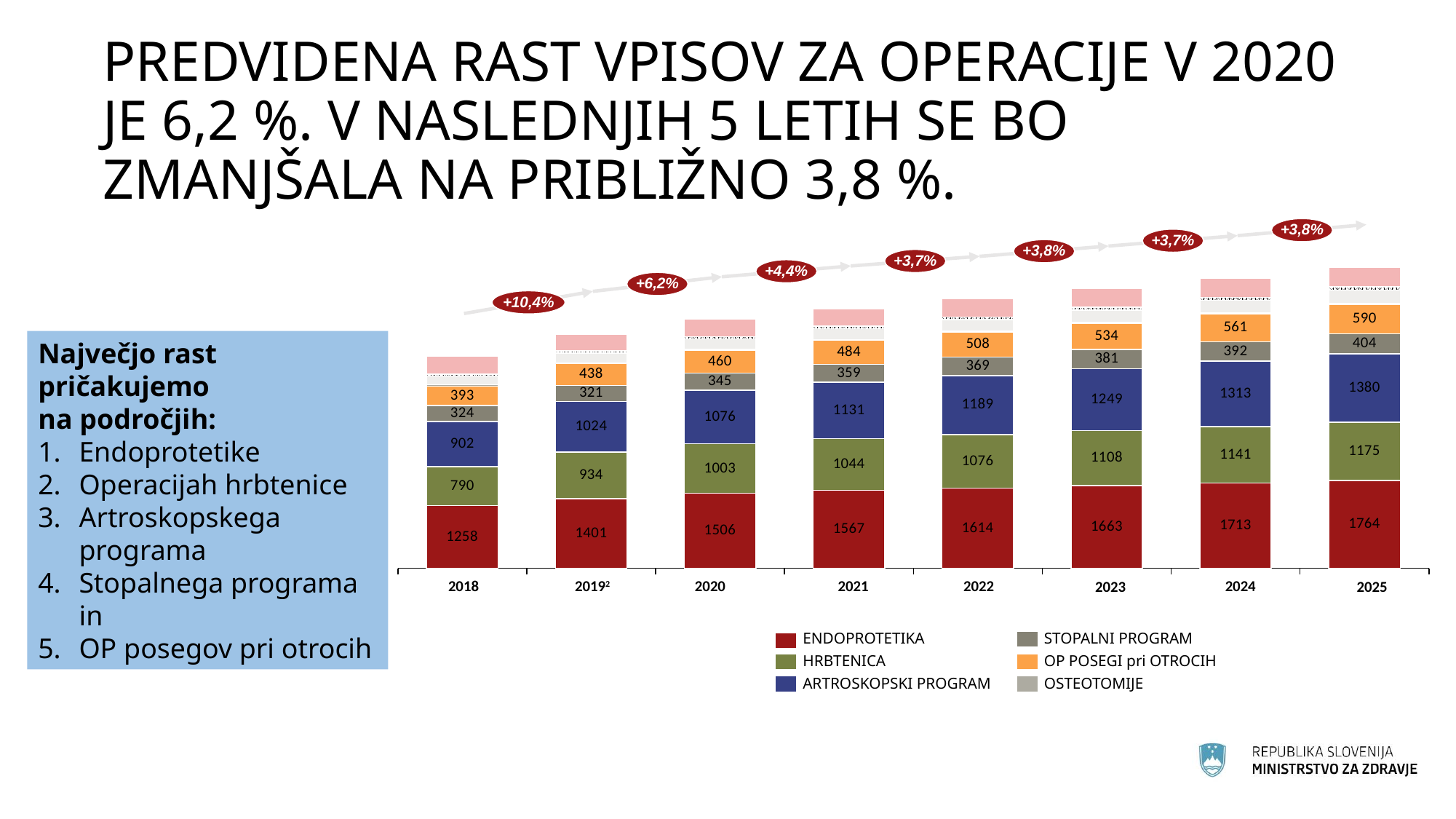
What is the value for OP POSEGI pri OTROCIH in 2018? 393 What growth percentage is shown in the label between 2019 and 2020? +6,2% How many series does the chart legend list? 6 What is the value for ENDOPROTETIKA in 2020? 1506 In which year is the ENDOPROTETIKA value highest? 2025 How many years are shown on the x axis of the chart? 8 What is the value for HRBTENICA in 2023? 1108 What is the value for ARTROSKOPSKI PROGRAM in 2025? 1380 What type of chart is shown on the slide? stacked bar chart Which is larger in 2022: the HRBTENICA value or the ARTROSKOPSKI PROGRAM value? ARTROSKOPSKI PROGRAM In which year is the STOPALNI PROGRAM value lowest? 2019 What is the difference between the ENDOPROTETIKA values for 2025 and 2018? 506